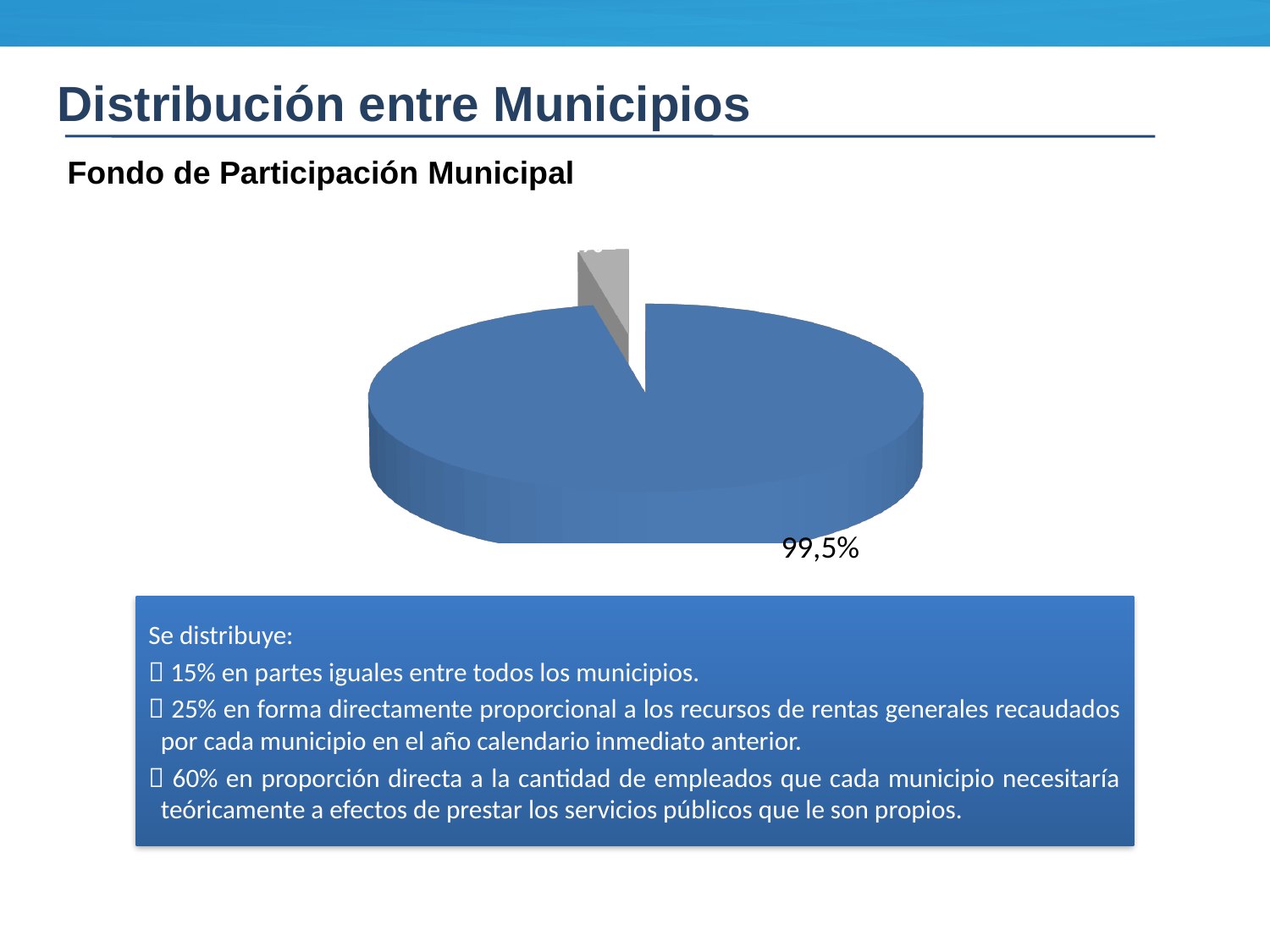
What percentage is printed on the large blue slice of the pie chart? 99,5% Which slice of the pie chart is larger, the blue one or the grey one? the blue one What is the subtitle printed above the pie chart? Fondo de Participación Municipal What kind of chart is shown on the slide? pie chart How many slices does the pie chart have? 2 Is the share of the blue slice greater or less than 50%? greater What colour is the largest slice of the pie chart? blue